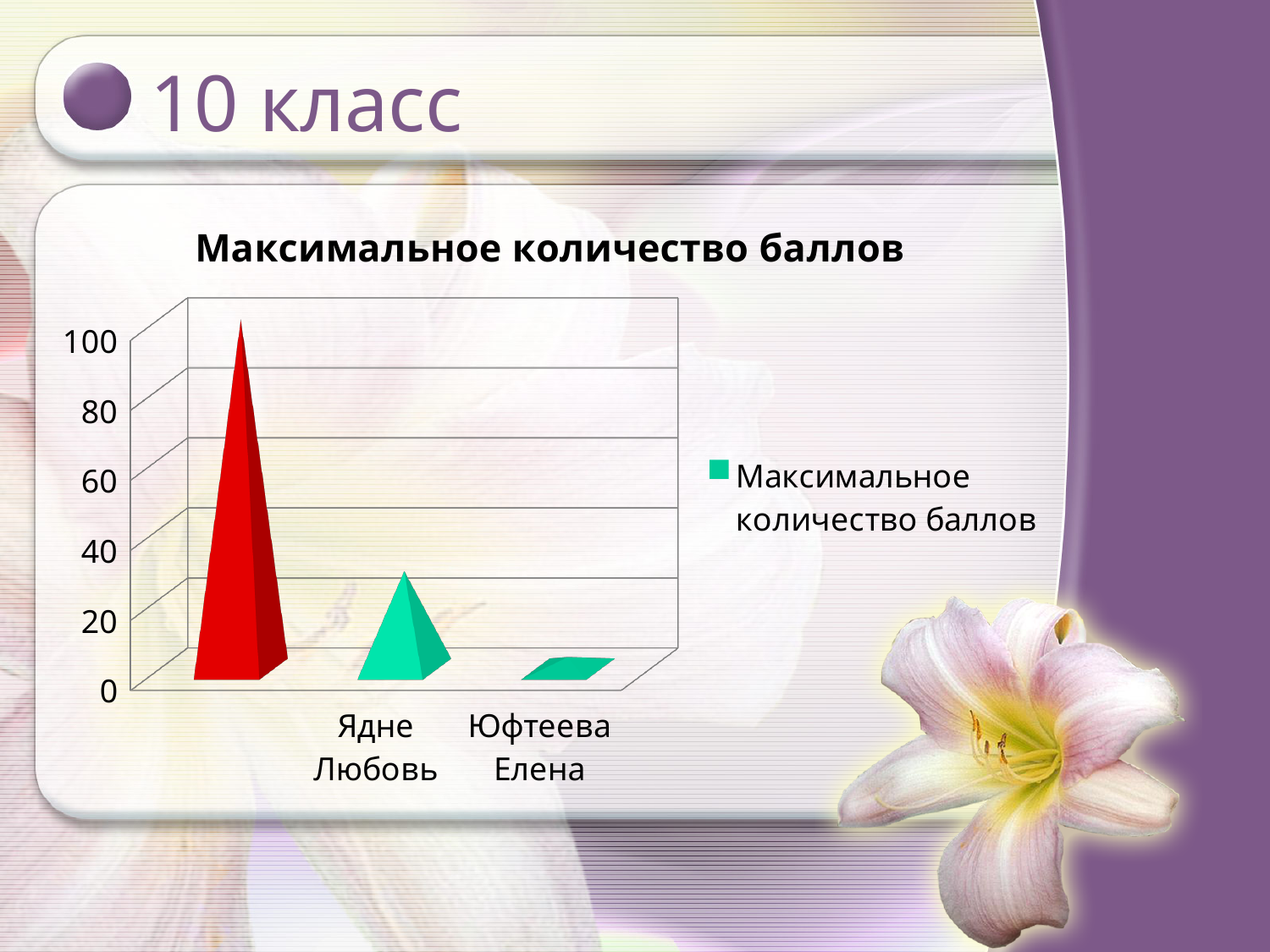
Is the value for Юфтеева Елена greater or less than 20? less What is the legend entry shown next to the chart? Максимальное количество баллов What is the title of the chart? Максимальное количество баллов Is the value for Ядне Любовь greater or less than 40? less Which is larger, the value for Ядне Любовь or the value for Юфтеева Елена? Ядне Любовь How many series does the legend list? 1 Is the value for Ядне Любовь greater or less than 20? greater How many bars are plotted in the chart? 3 What kind of chart is shown on the slide? bar chart What is the highest value shown on the vertical axis? 100 Which labelled category has the lowest value? Юфтеева Елена